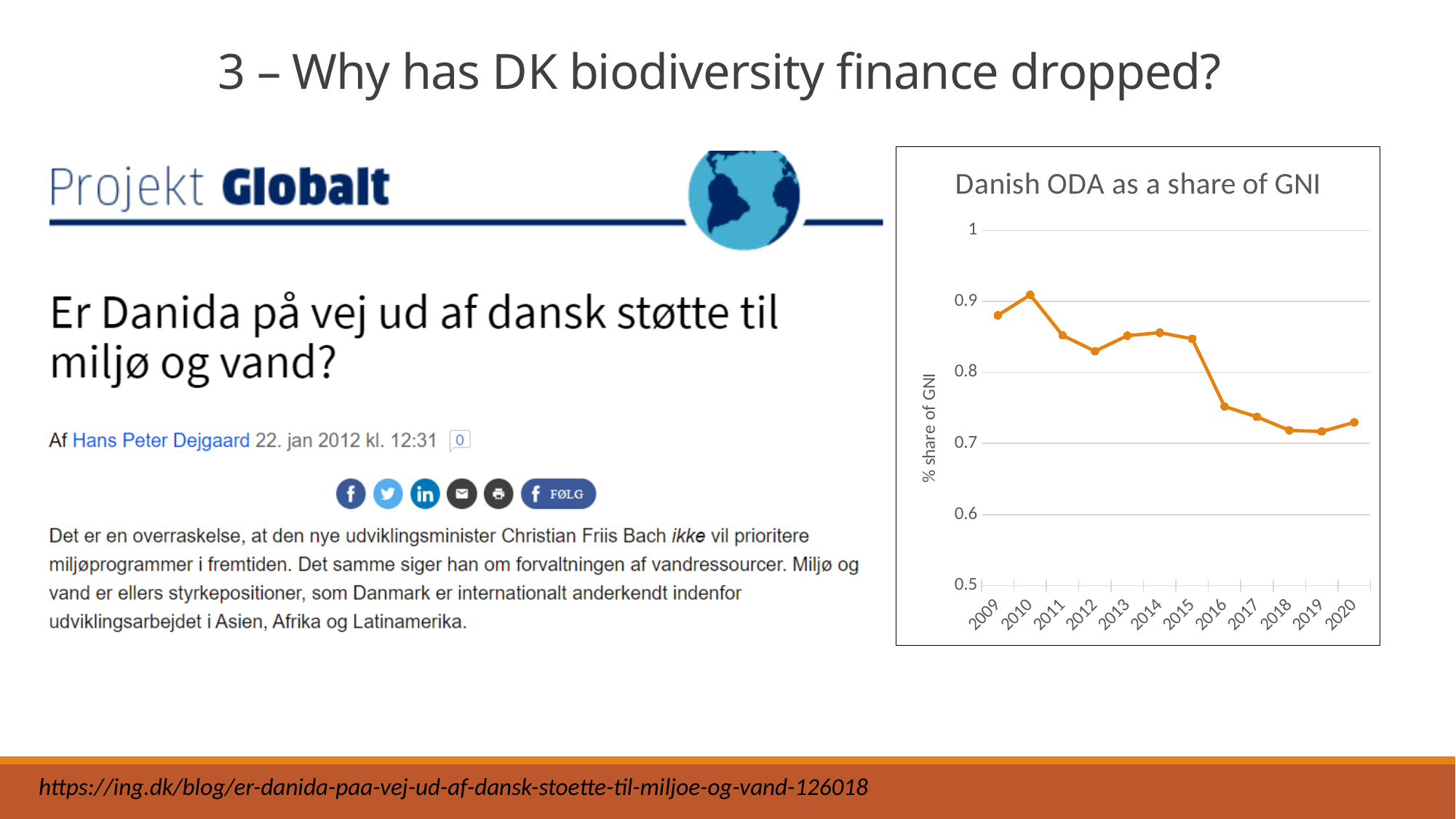
Is the value for 2009 greater or less than 0.9? less Is the value for 2016 greater or less than 0.8? less Is the value for 2018 greater or less than 0.7? greater Which year has the larger value, 2015 or 2017? 2015 What is the label on the vertical axis of the chart? % share of GNI What is the title of the chart on the slide? Danish ODA as a share of GNI How many years are plotted on the chart? 12 Overall, does Danish ODA as a share of GNI rise or fall from 2009 to 2020? fall In which year is Danish ODA as a share of GNI highest? 2010 What type of chart is shown on the slide? line chart